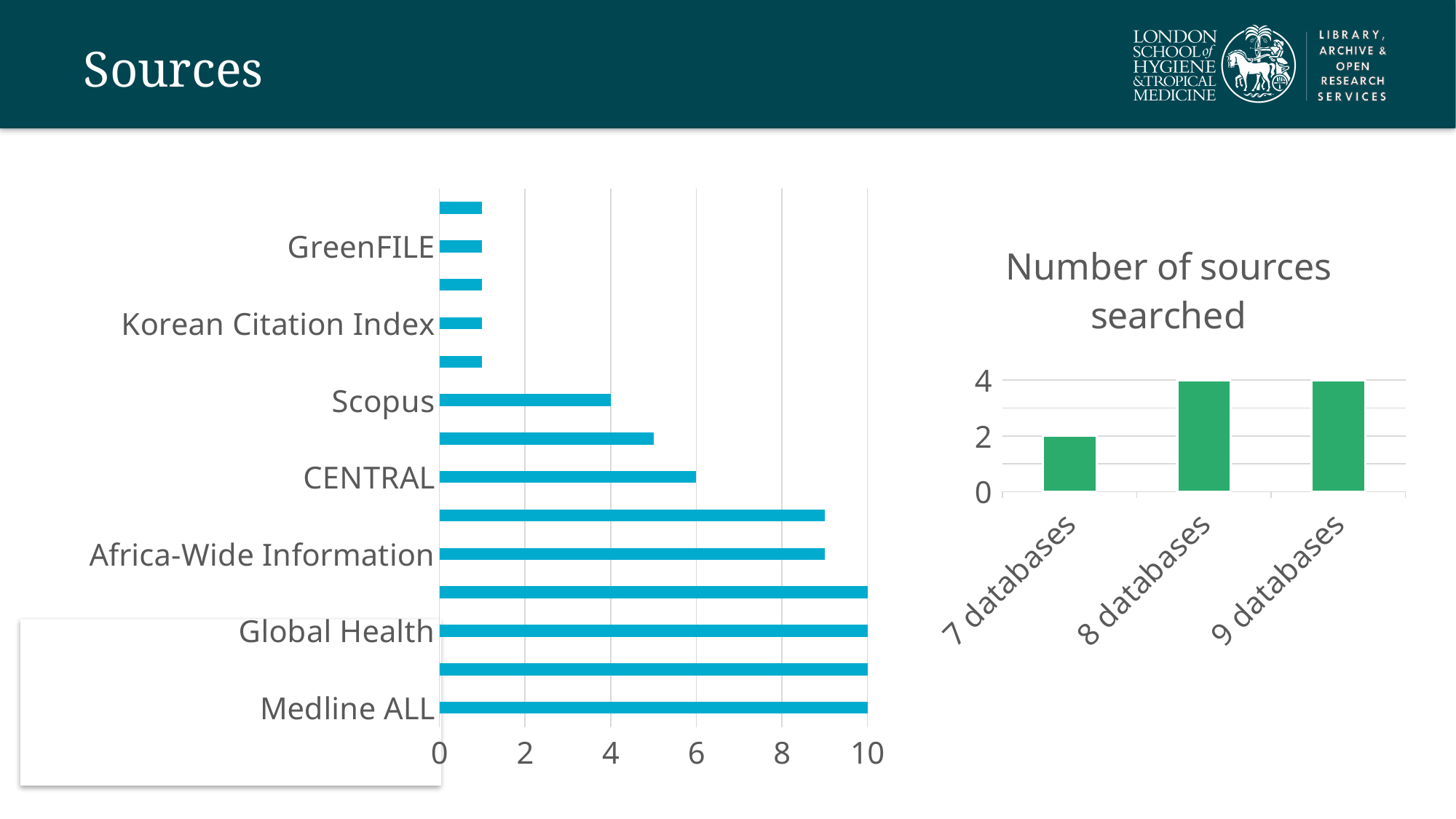
What is the title of the chart on the right of the slide? Number of sources searched In the chart on the left of the slide, what is the value for Scopus? 4 What kind of chart is the chart titled 'Number of sources searched'? Bar chart In the chart on the left of the slide, which is larger, the value for CENTRAL or the value for Scopus? CENTRAL In the chart on the left of the slide, what is the difference between the value for Medline ALL and the value for Scopus? 6 In the chart titled 'Number of sources searched', what is the value for 7 databases? 2 In the chart on the left of the slide, is the value for Africa-Wide Information greater or less than 8? greater In the chart titled 'Number of sources searched', which category has the lowest value? 7 databases In the chart titled 'Number of sources searched', what is the value for 8 databases? 4 In the chart on the left of the slide, what is the value for Medline ALL? 10 In the chart on the left of the slide, what is the value for CENTRAL? 6 How many categories are shown in the chart titled 'Number of sources searched'? 3